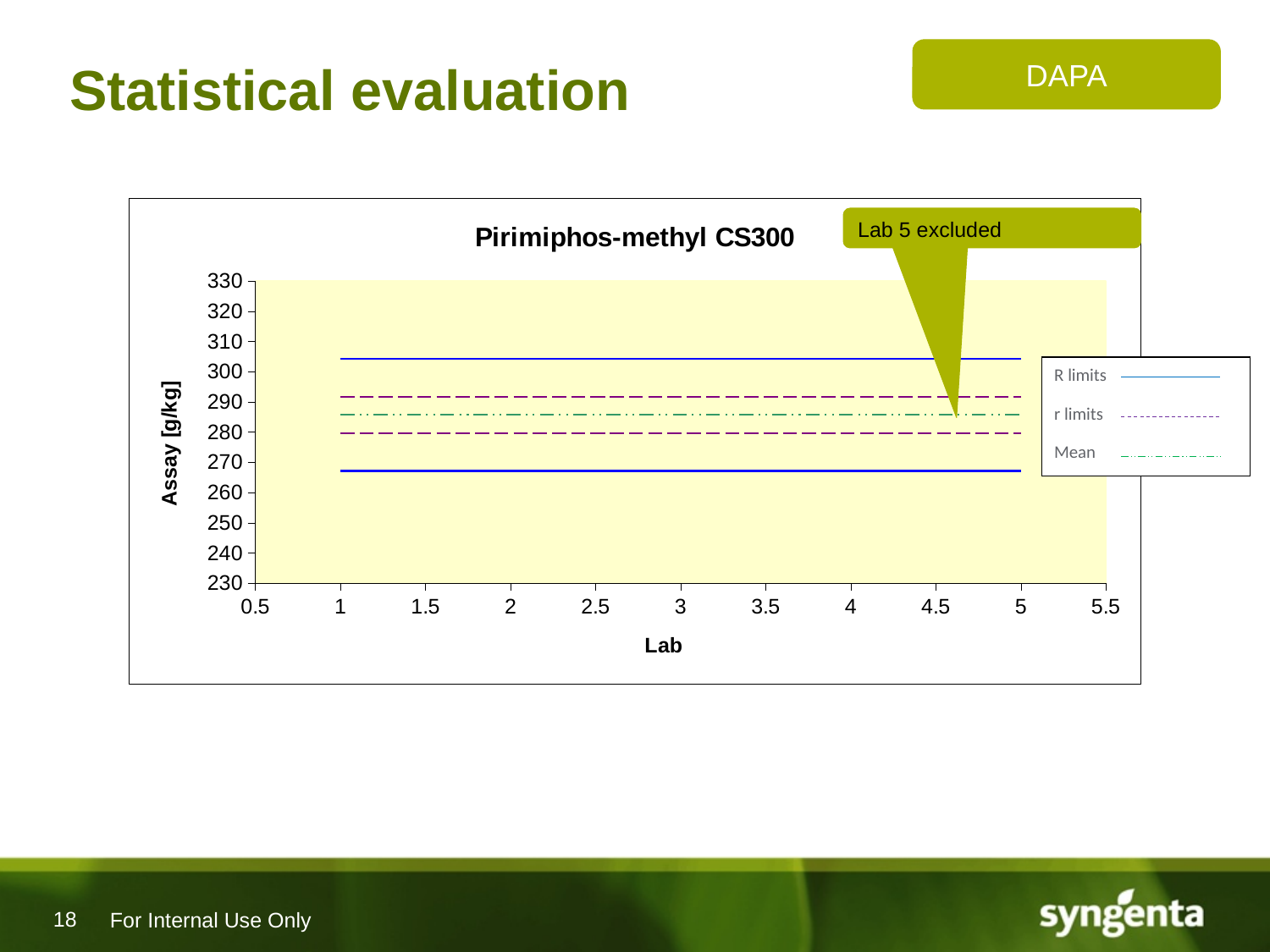
Which is higher on the chart, the upper R limits line or the upper r limits line? upper R limits line Is the upper R limits line greater or less than 300 g/kg? greater What is the label of the y axis? Assay [g/kg] Is the lower R limits line greater or less than 270 g/kg? less How many series does the chart legend list? 3 What kind of chart is shown on the slide? line chart Is the Mean line greater or less than 290 g/kg? less Do the plotted lines rise, fall, or stay flat across the Lab axis? stay flat What is the title of the chart? Pirimiphos-methyl CS300